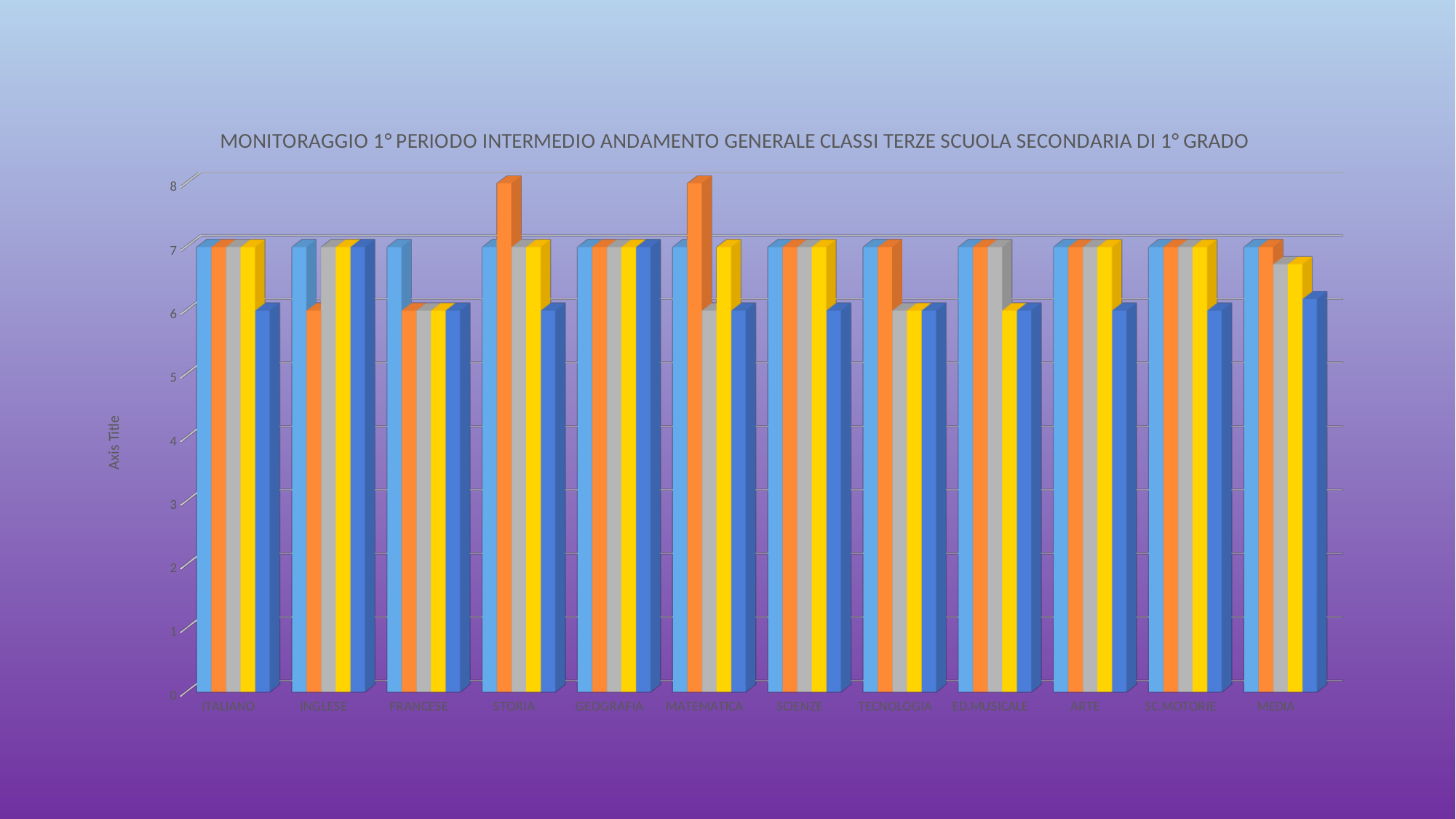
What is the difference between the orange bar and the dark blue bar for STORIA? 2 What is the value of the dark blue bar for ITALIANO? 6 What is the value of the light blue bar for ITALIANO? 7 What kind of chart is shown on the slide? bar chart What is the value of the orange bar for STORIA? 8 Is the yellow bar for MEDIA greater or less than 7? less What is the title of the chart? MONITORAGGIO 1° PERIODO INTERMEDIO ANDAMENTO GENERALE CLASSI TERZE SCUOLA SECONDARIA DI 1° GRADO How many categories are shown on the x axis of the chart? 12 What is the label shown on the vertical axis of the chart? Axis Title How many bars are plotted for each category in the chart? 5 Which is larger, the orange bar for STORIA or the orange bar for ITALIANO? STORIA Is the orange bar for MATEMATICA greater or less than 7? greater